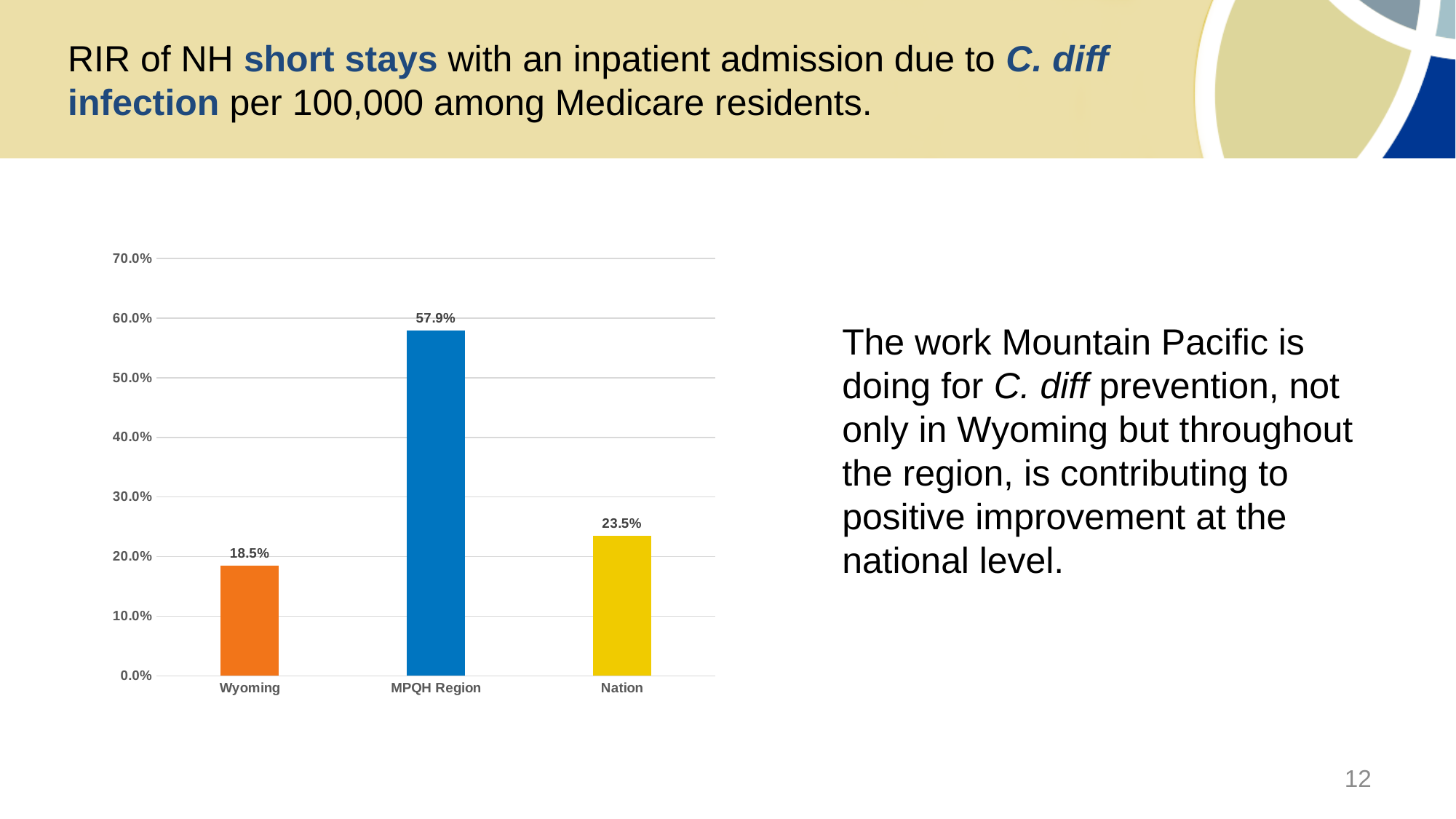
What is the value for Nation? 23.5% What is the value for MPQH Region? 57.9% Is the value for MPQH Region greater or less than 50.0%? greater What colour is the bar for Nation? yellow What is the difference between the Nation value and the Wyoming value? 5.0% What is the difference between the MPQH Region value and the Wyoming value? 39.4% Which category has the lowest value? Wyoming Which category has the highest value? MPQH Region What kind of chart is shown on the slide? bar chart Which is larger, the value for Nation or the value for Wyoming? Nation How many categories are shown on the x axis? 3 What is the value for Wyoming? 18.5%